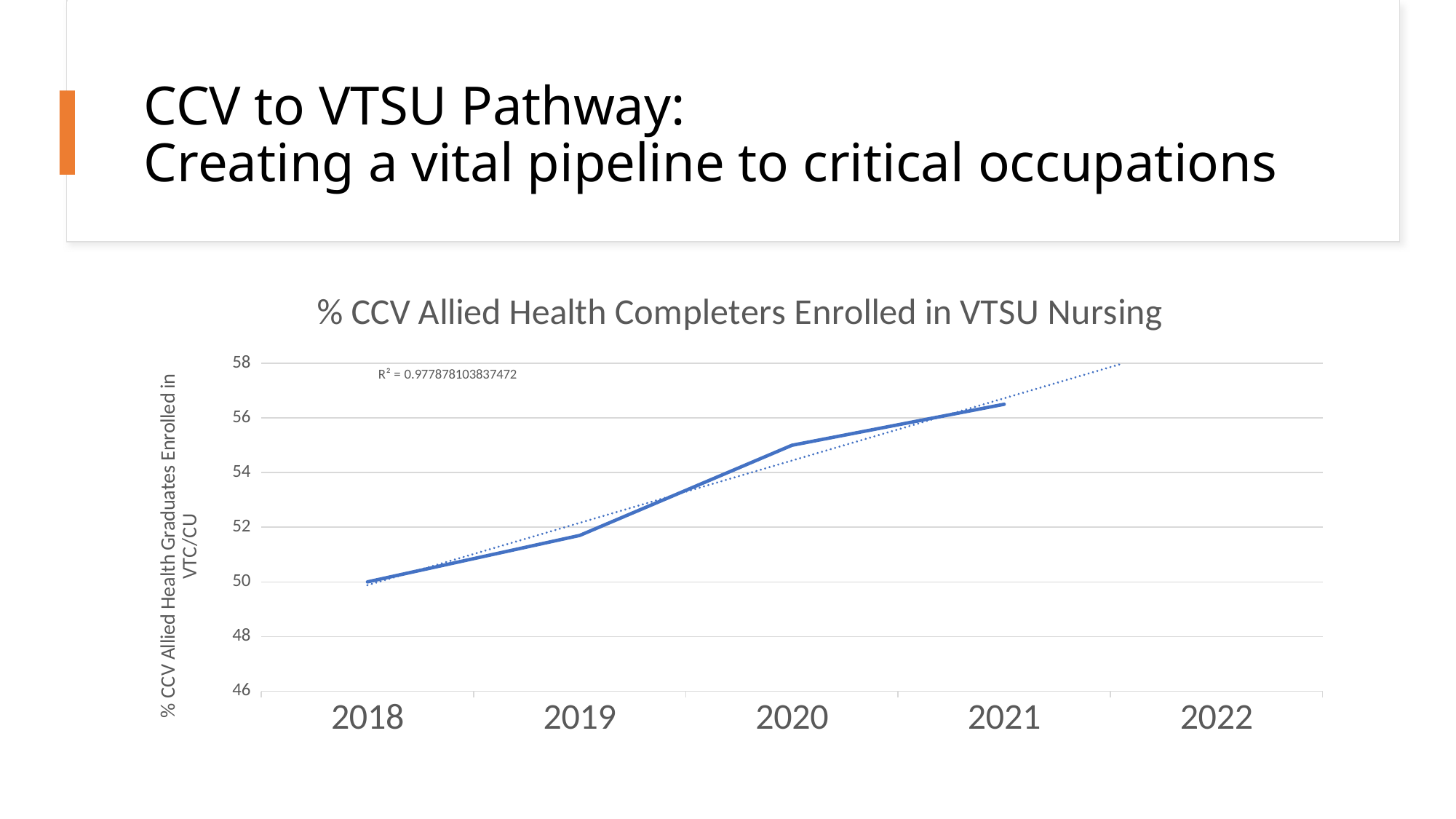
Which is larger, the value for 2019 or the value for 2020? 2020 What type of chart is shown on the slide? line chart Is the value for 2019 greater or less than 52? less How many years have a plotted data point on the solid line? 4 What R-squared value is printed on the chart? R² = 0.977878103837472 Which year has the lowest value on the plotted line? 2018 What is the title of the chart? % CCV Allied Health Completers Enrolled in VTSU Nursing Is the value for 2021 greater or less than 58? less Do the values rise or fall from 2018 to 2021? rise Is the value for 2020 greater or less than 54? greater Which year has the highest value on the plotted line? 2021